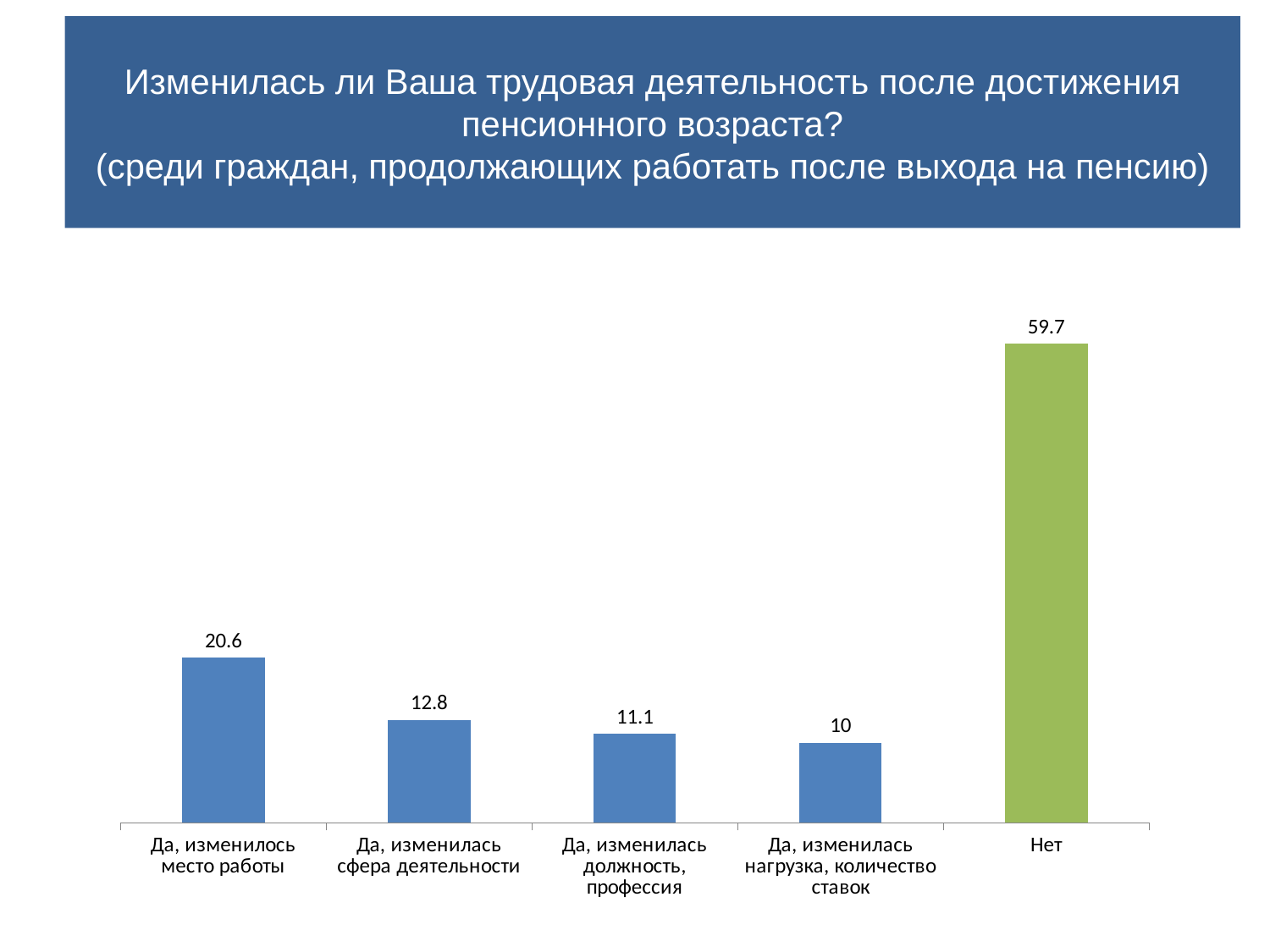
What is the difference between the values for "Нет" and "Да, изменилось место работы"? 39.1 What is the value for "Да, изменилось место работы"? 20.6 What kind of chart is shown on the slide? Bar chart What is the value for "Нет"? 59.7 What is the value for "Да, изменилась нагрузка, количество ставок"? 10 Which category has the highest value? Нет What is the value for "Да, изменилась сфера деятельности"? 12.8 What is the difference between the values for "Да, изменилась сфера деятельности" and "Да, изменилась должность, профессия"? 1.7 How many categories are shown in the chart? 5 Which is larger: the value for "Да, изменилось место работы" or for "Да, изменилась должность, профессия"? Да, изменилось место работы Which bar is shown in a different colour (green) from the others? Нет Which category has the lowest value? Да, изменилась нагрузка, количество ставок